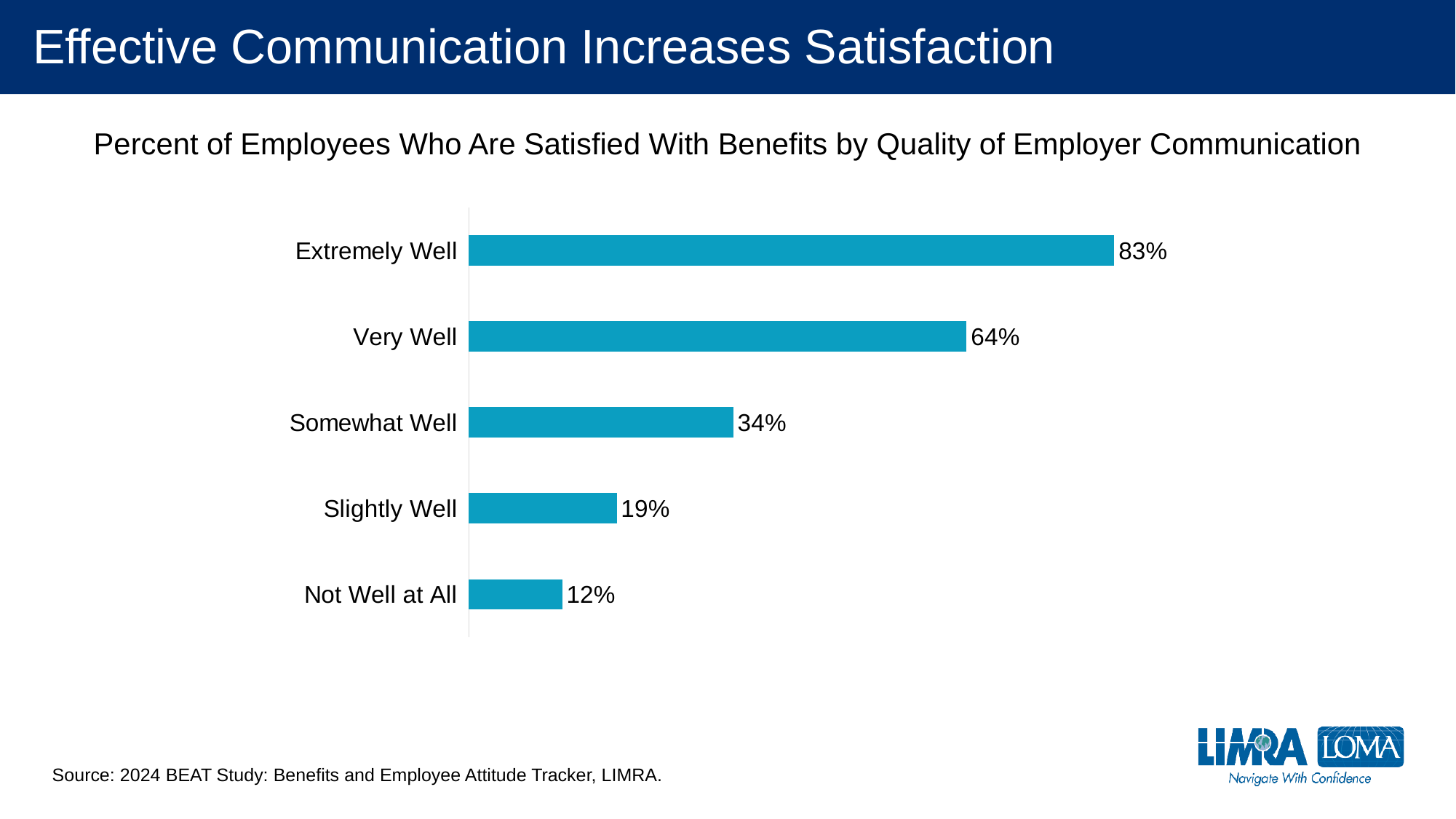
What is the value for Not Well at All? 12% Which category has the highest percentage of satisfied employees? Extremely Well Which is larger, the value for Very Well or the value for Somewhat Well? Very Well How many categories are shown in the chart? 5 What percent of employees whose employer communicates Extremely Well are satisfied with benefits? 83% What is the value for Somewhat Well? 34% What is the source cited for the chart data? 2024 BEAT Study: Benefits and Employee Attitude Tracker, LIMRA. What is the title of the chart? Percent of Employees Who Are Satisfied With Benefits by Quality of Employer Communication What is the difference between the values for Extremely Well and Very Well? 19 percentage points Which category has the lowest percentage of satisfied employees? Not Well at All What kind of chart is shown on the slide? Bar chart What is the difference between the values for Slightly Well and Not Well at All? 7 percentage points